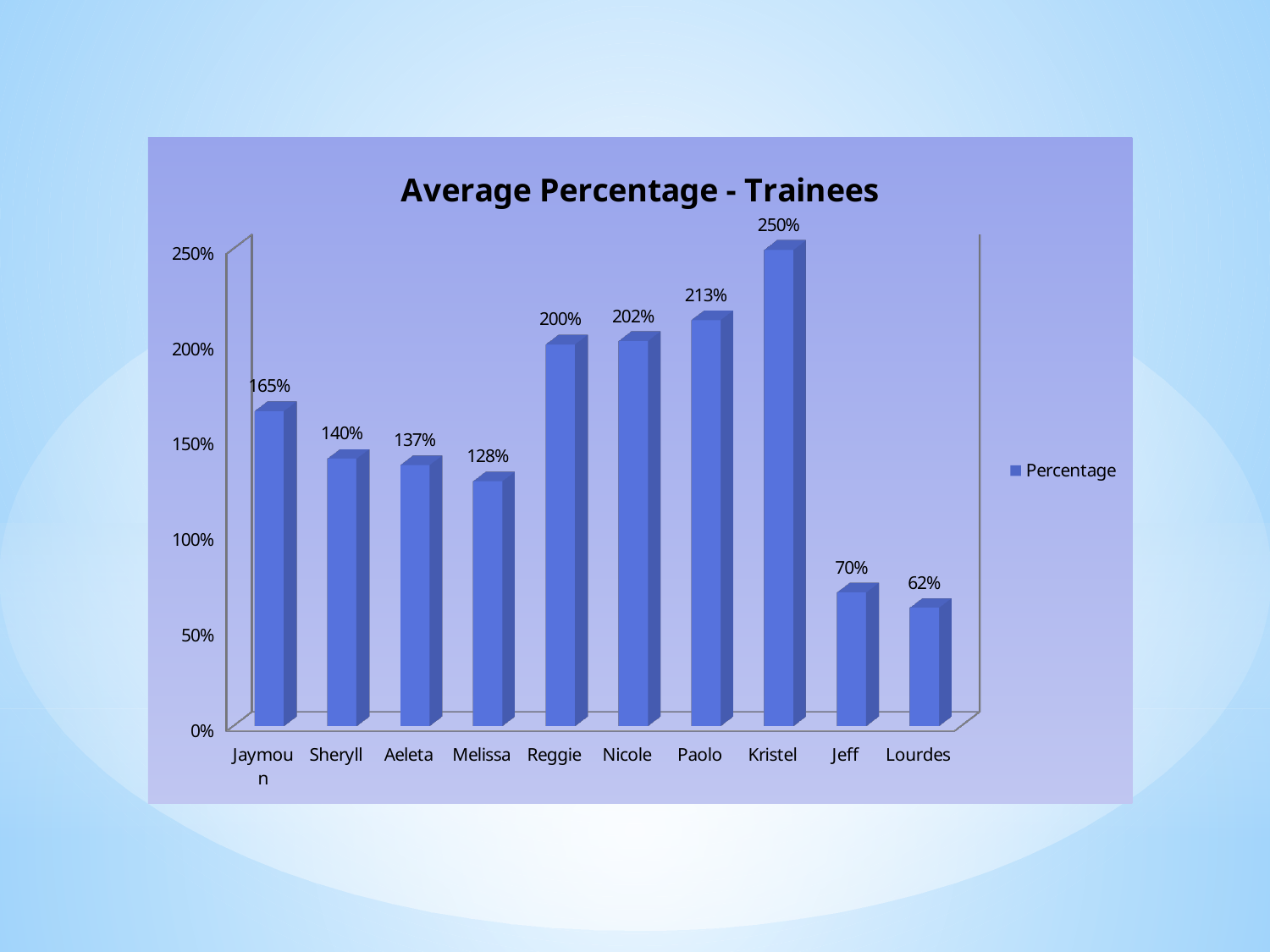
How many trainees are shown on the x axis? 10 What is the title of the chart? Average Percentage - Trainees Is the value for Reggie greater or less than 150%? greater What is the difference between the values for Paolo and Sheryll? 73% What is the value for Melissa? 128% Which trainee has the lowest percentage? Lourdes How many series does the legend list? 1 Which trainee has the highest percentage? Kristel What kind of chart is shown on the slide? Bar chart What is the value for Kristel? 250% What is the value for Jeff? 70% Which is larger, the value for Jaymoun or the value for Aeleta? Jaymoun